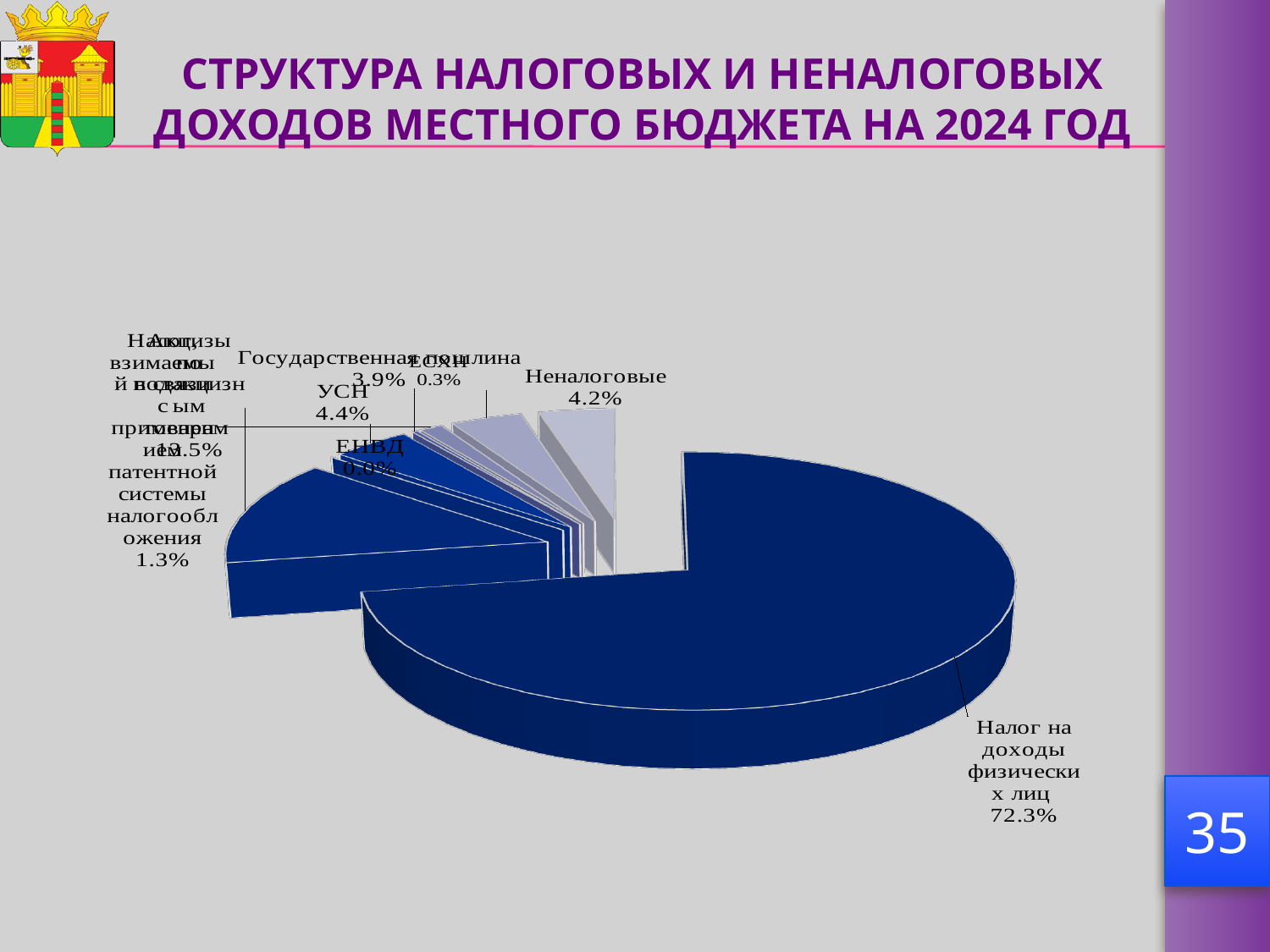
Which is larger, the share for "УСН" or the share for "Государственная пошлина"? УСН What share of the pie is labelled for "Налог на доходы физических лиц"? 72.3% What kind of chart is shown on the slide? pie chart What is the difference between the share for "Неналоговые" and the share for "Государственная пошлина"? 0.3% What percentage is shown for "ЕСХН"? 0.3% What percentage is shown for "УСН"? 4.4% Which category has the largest share of the pie? Налог на доходы физических лиц What percentage is shown for "Неналоговые"? 4.2% What percentage is shown for "ЕНВД"? 0.0% What percentage is shown for the tax related to the patent system of taxation (патентной системы налогообложения)? 1.3% What percentage is shown for "Государственная пошлина"? 3.9% Which category has the smallest share of the pie? ЕНВД